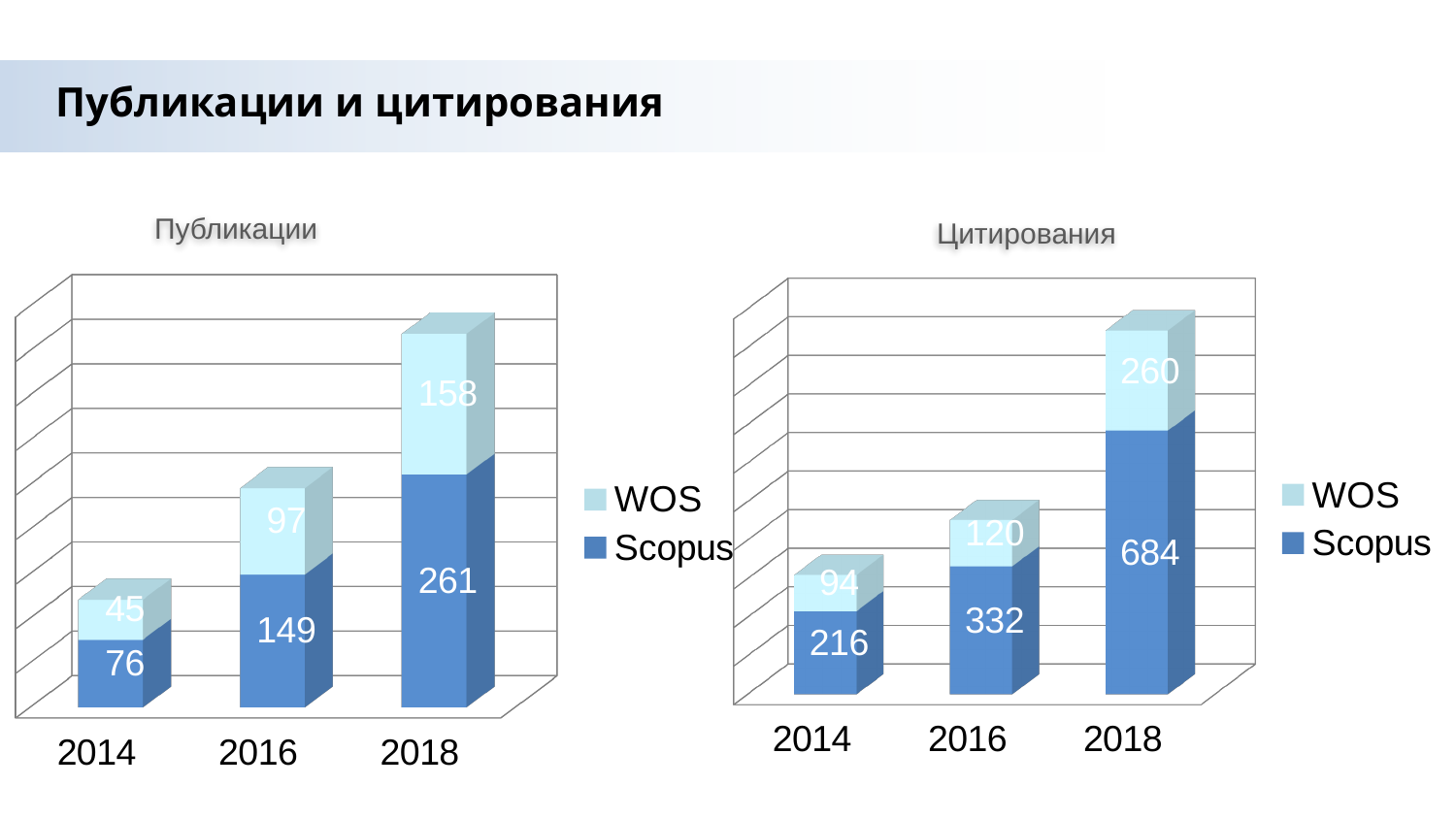
In the Цитирования chart, what is the total of the stacked bar for 2016? 452 In the Публикации chart, what is the Scopus value for 2016? 149 In the Цитирования chart, which is larger: the WOS value for 2016 or the WOS value for 2018? 2018 How many series does the legend of the Публикации chart list? 2 In the Цитирования chart, which year has the lowest WOS value? 2014 In the Публикации chart, what is the difference between the Scopus values for 2018 and 2014? 185 In the Публикации chart, which year has the highest Scopus value? 2018 In the Цитирования chart, what is the WOS value for 2014? 94 In the Публикации chart, what is the total of the stacked bar for 2018? 419 In the Цитирования chart, what is the Scopus value for 2018? 684 What kind of chart is the Цитирования chart? Stacked bar chart In the Публикации chart, what is the WOS value for 2018? 158